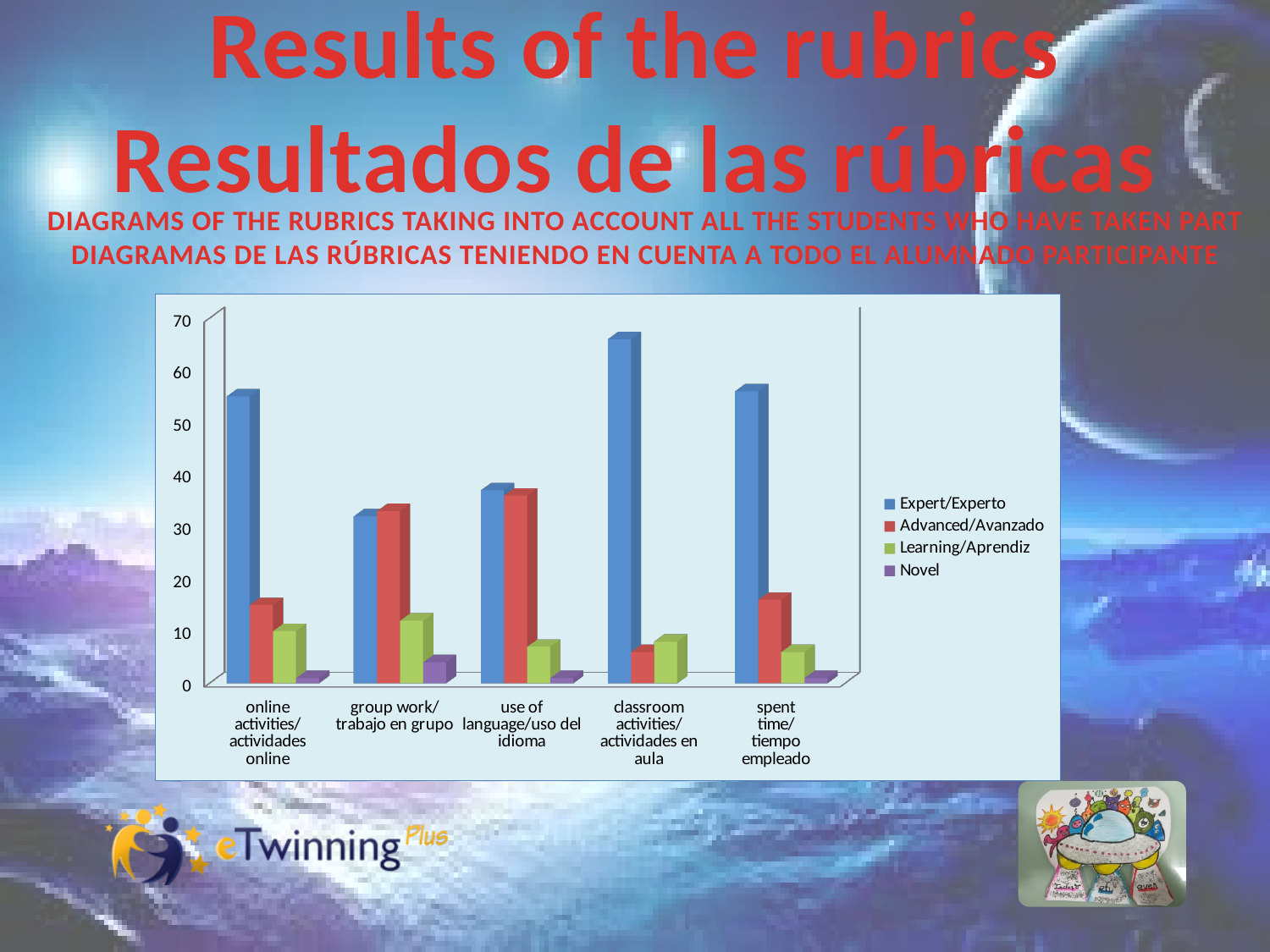
Which category has the highest Expert/Experto value? classroom activities/actividades en aula Which category has the lowest Advanced/Avanzado value? classroom activities/actividades en aula Is the Expert/Experto value for group work/trabajo en grupo greater or less than 40? less Is the Expert/Experto value for online activities/actividades online greater or less than 50? greater Is the Advanced/Avanzado value for online activities/actividades online greater or less than 20? less Which colour represents the Novel series in the chart's legend? purple For online activities/actividades online, which is larger: the Expert/Experto value or the Advanced/Avanzado value? Expert/Experto How many categories are shown on the x axis of the chart? 5 How many series does the chart's legend list? 4 Which category has the lowest Expert/Experto value? group work/trabajo en grupo What kind of chart is shown on the slide? bar chart